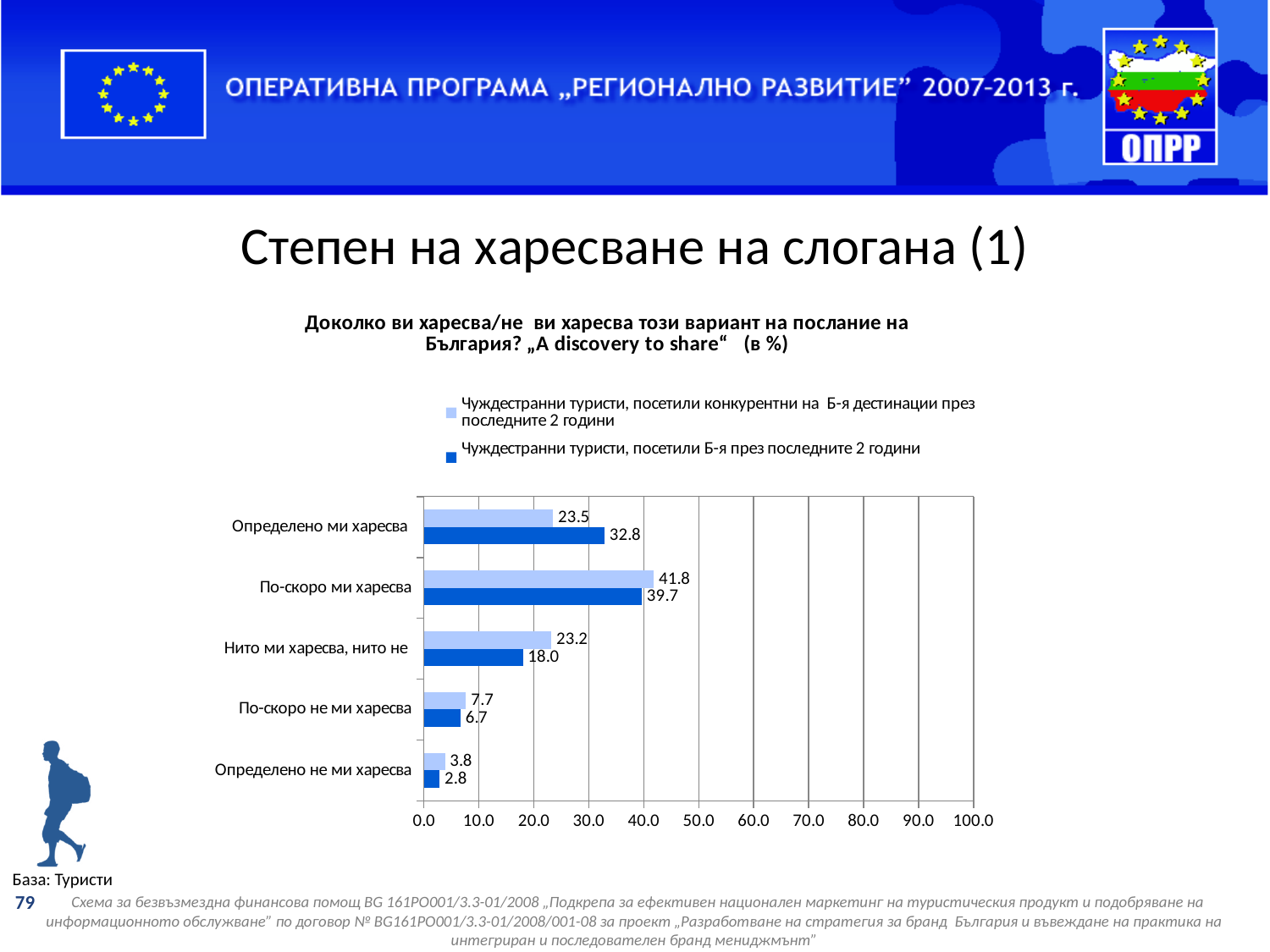
What is the value for "Определено не ми харесва" for the series "Чуждестранни туристи, посетили Б-я през последните 2 години"? 2.8 How many categories are shown on the chart? 5 What is the value for "Нито ми харесва, нито не" for the series "Чуждестранни туристи, посетили Б-я през последните 2 години"? 18.0 Which category has the lowest value for the series "Чуждестранни туристи, посетили конкурентни на Б-я дестинации през последните 2 години"? Определено не ми харесва Is the value for "По-скоро ми харесва" for tourists who visited Bulgaria greater or less than 30.0? greater What is the value for "По-скоро ми харесва" for the series "Чуждестранни туристи, посетили конкурентни на Б-я дестинации през последните 2 години"? 41.8 What kind of chart is shown on the slide? Bar chart For "Нито ми харесва, нито не", which series has the larger value? Чуждестранни туристи, посетили конкурентни на Б-я дестинации през последните 2 години How many series does the legend list? 2 What is the difference between the two series for "Определено ми харесва"? 9.3 What is the value for "Определено ми харесва" for the series "Чуждестранни туристи, посетили Б-я през последните 2 години"? 32.8 Which category has the highest value for the series "Чуждестранни туристи, посетили Б-я през последните 2 години"? По-скоро ми харесва